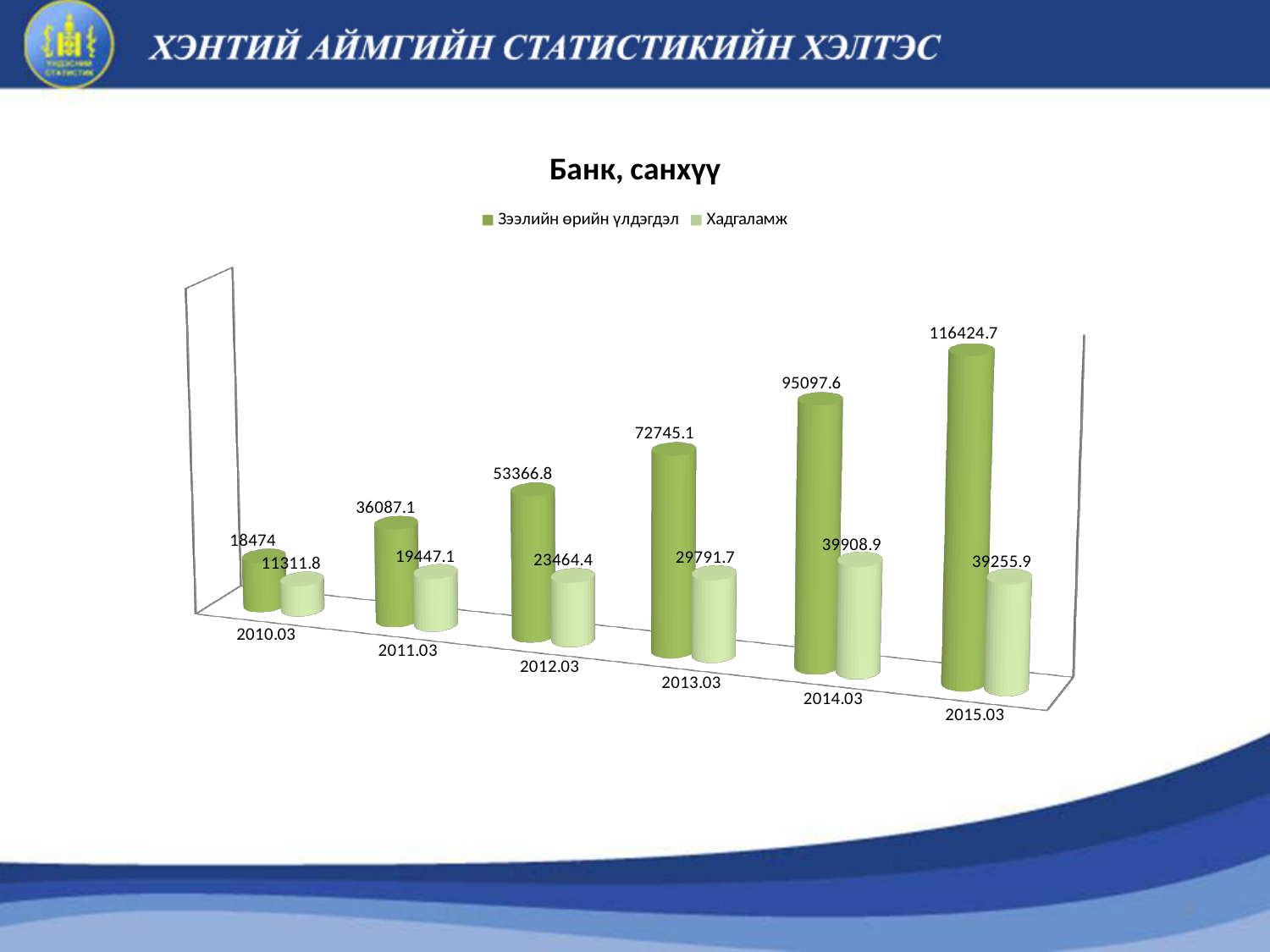
What is the value of Зээлийн өрийн үлдэгдэл for 2010.03? 18474 How many periods are shown on the x axis? 6 What is the value of Хадгаламж for 2012.03? 23464.4 What is the value of Хадгаламж for 2013.03? 29791.7 Which period has the lowest value for Хадгаламж? 2010.03 Which period has the highest value for Зээлийн өрийн үлдэгдэл? 2015.03 What is the difference between the Зээлийн өрийн үлдэгдэл values for 2011.03 and 2010.03? 17613.1 What is the difference between Зээлийн өрийн үлдэгдэл and Хадгаламж in 2015.03? 77168.8 Which is larger: Хадгаламж in 2014.03 or Хадгаламж in 2015.03? 2014.03 Does the value of Зээлийн өрийн үлдэгдэл rise or fall from 2010.03 to 2015.03? rise How many series does the legend list? 2 What is the value of Зээлийн өрийн үлдэгдэл for 2015.03? 116424.7